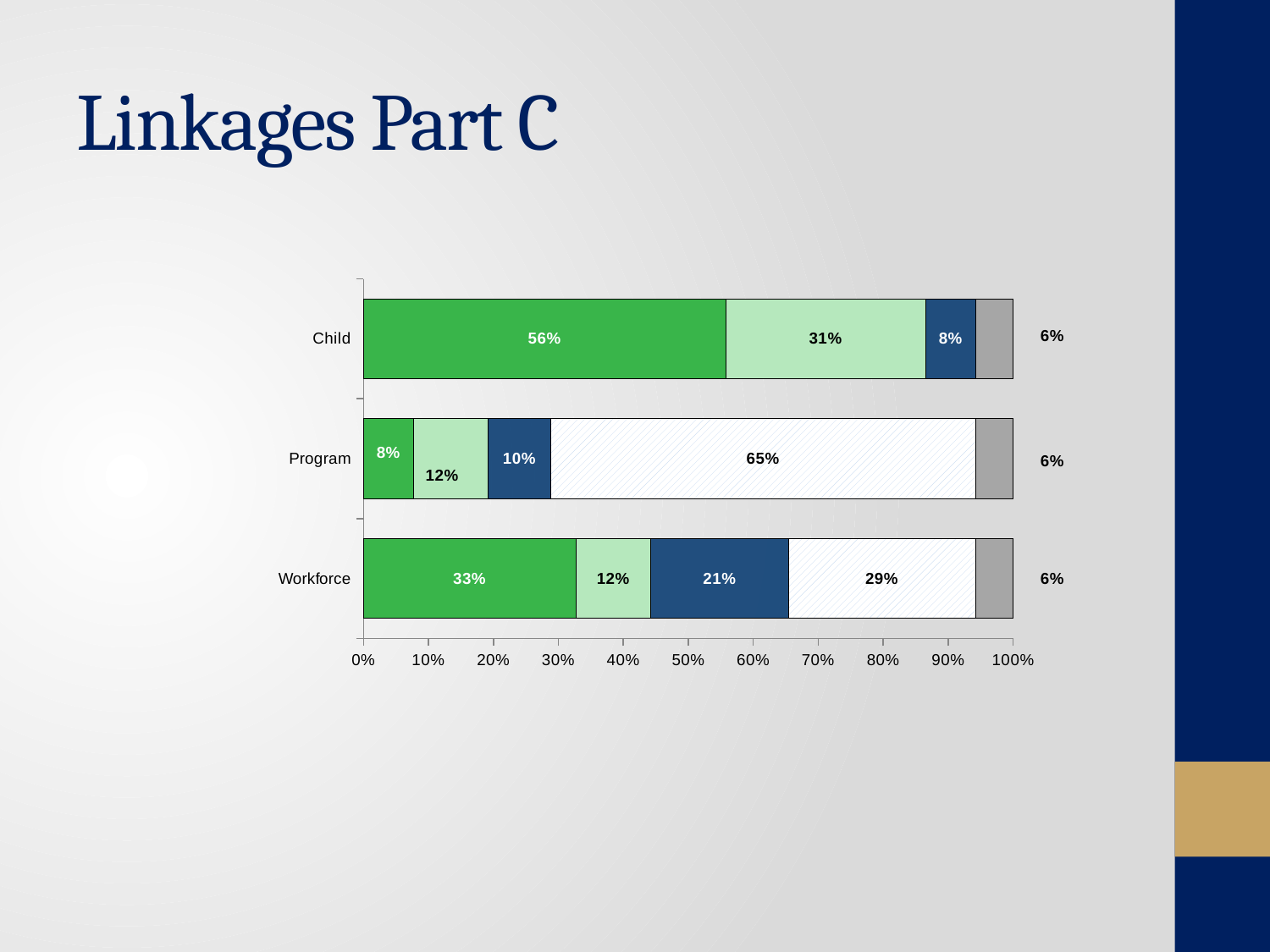
What is the value of the white hatched segment for Program? 65% Which category has the largest dark green segment? Child What is the value of the dark blue segment for Workforce? 21% What is the value of the light green segment for Child? 31% What is the title of the slide containing the chart? Linkages Part C Which category has the smallest dark green segment? Program What value is labelled to the right of the gray segment for each of the three bars? 6% What kind of chart is shown on the slide? Stacked bar chart How many categories are shown on the vertical axis of the chart? 3 What is the value of the dark green segment for Child? 56% What is the difference between the dark green segment for Child and the dark green segment for Workforce? 23 percentage points Which is larger, the dark blue segment for Workforce or the dark blue segment for Program? Workforce